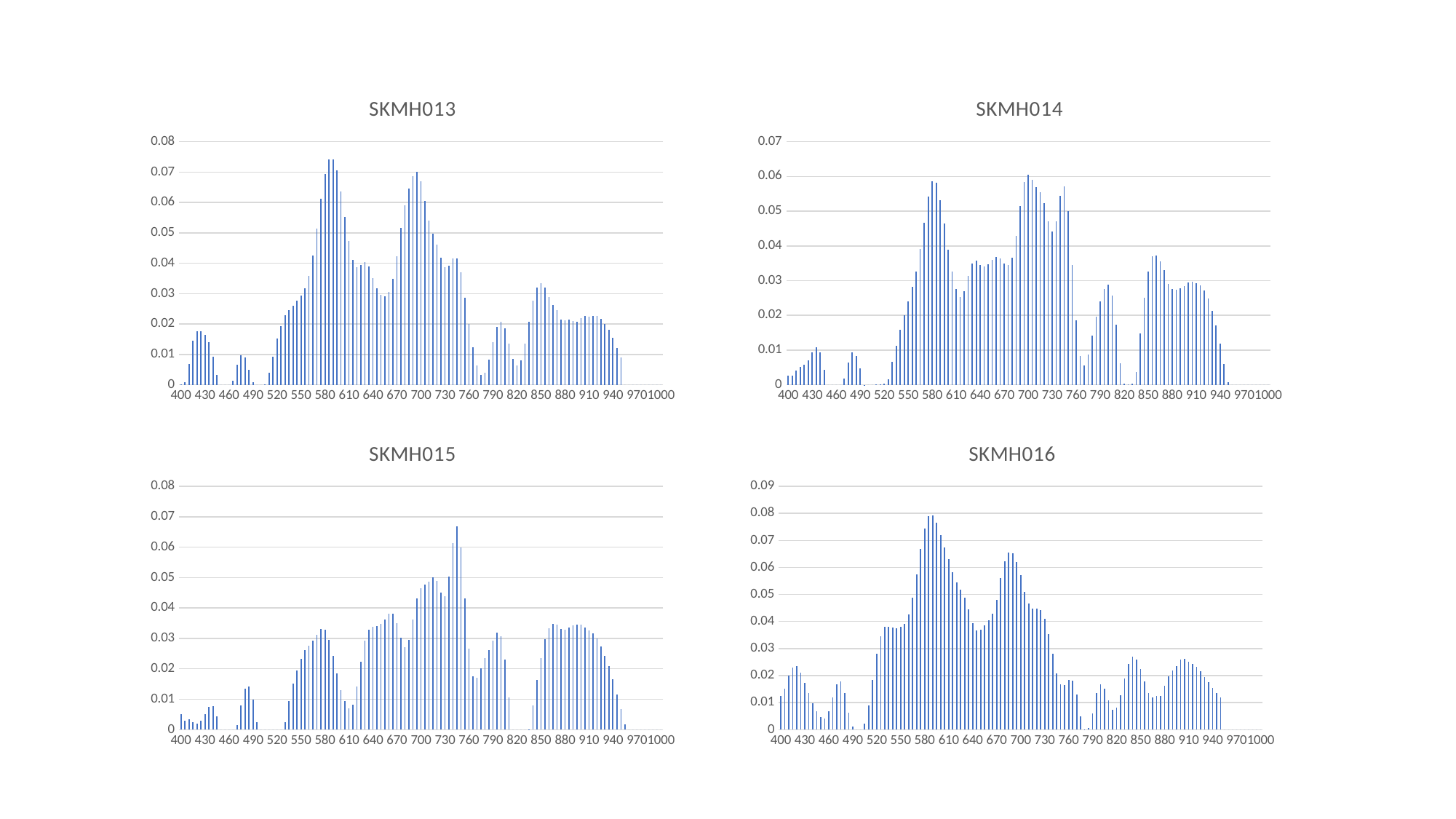
In the SKMH014 chart, is the value at 580 greater or less than 0.04? greater What kind of chart is SKMH013? bar chart In the SKMH013 chart, is the value at 850 greater or less than 0.02? greater In the SKMH015 chart, is the value at 580 greater or less than 0.05? less What is the highest value shown on the y axis of the SKMH016 chart? 0.09 How many charts are shown on the slide? 4 What is the title of the chart in the top-right position? SKMH014